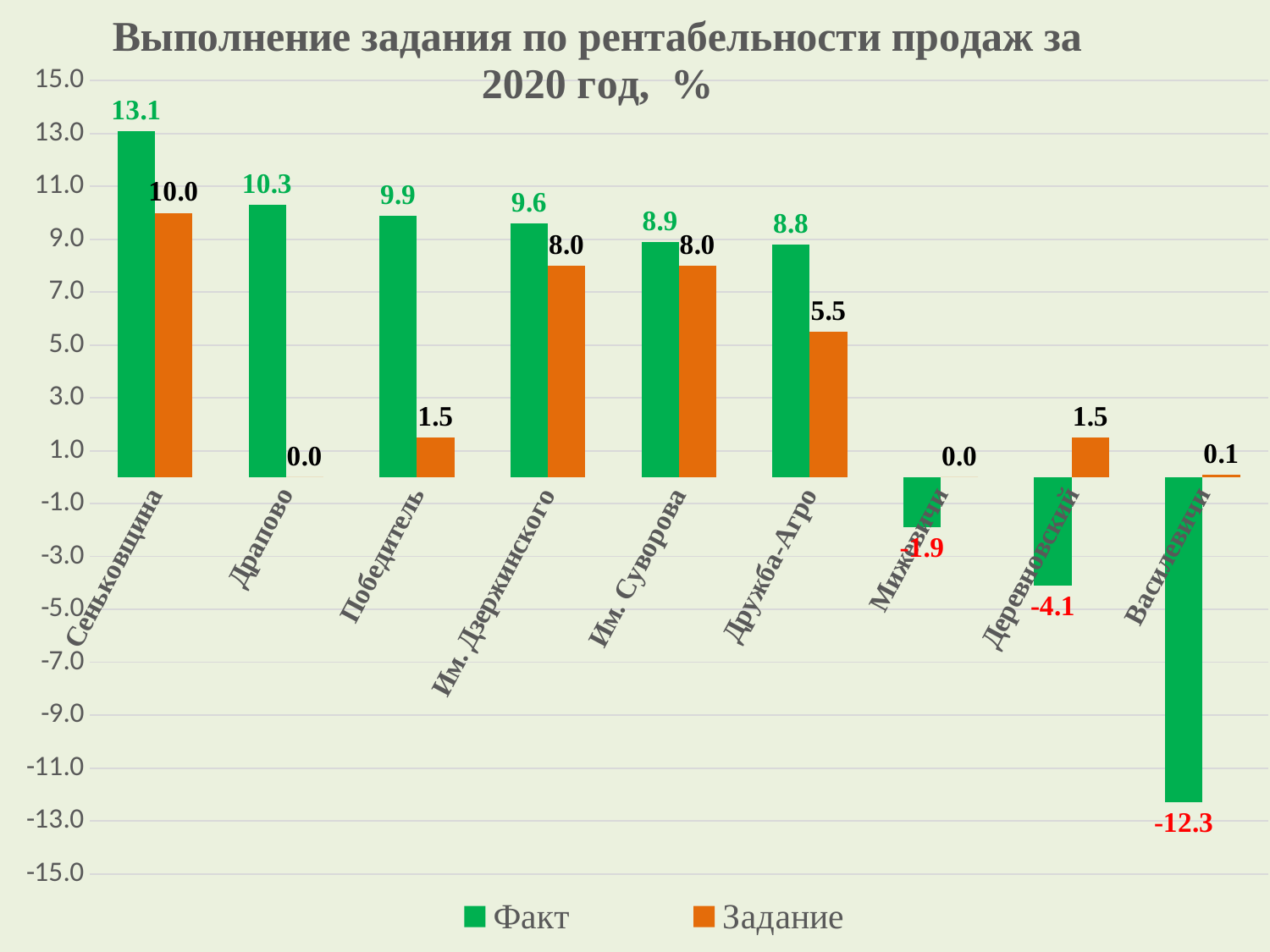
What is the Задание value for Деревновский? 1.5 Which category has the highest Факт value? Сеньковщина Which series is shown in orange? Задание How many series does the legend list? 2 What is the Факт value for Василевичи? -12.3 What kind of chart is shown on the slide? Bar chart Which category has the lowest Факт value? Василевичи What is the Задание value for Дружба-Агро? 5.5 Which is larger for Деревновский, the Факт value or the Задание value? Задание What is the Факт value for Сеньковщина? 13.1 What is the difference between the Факт and Задание values for Сеньковщина? 3.1 How many categories are shown on the x axis? 9